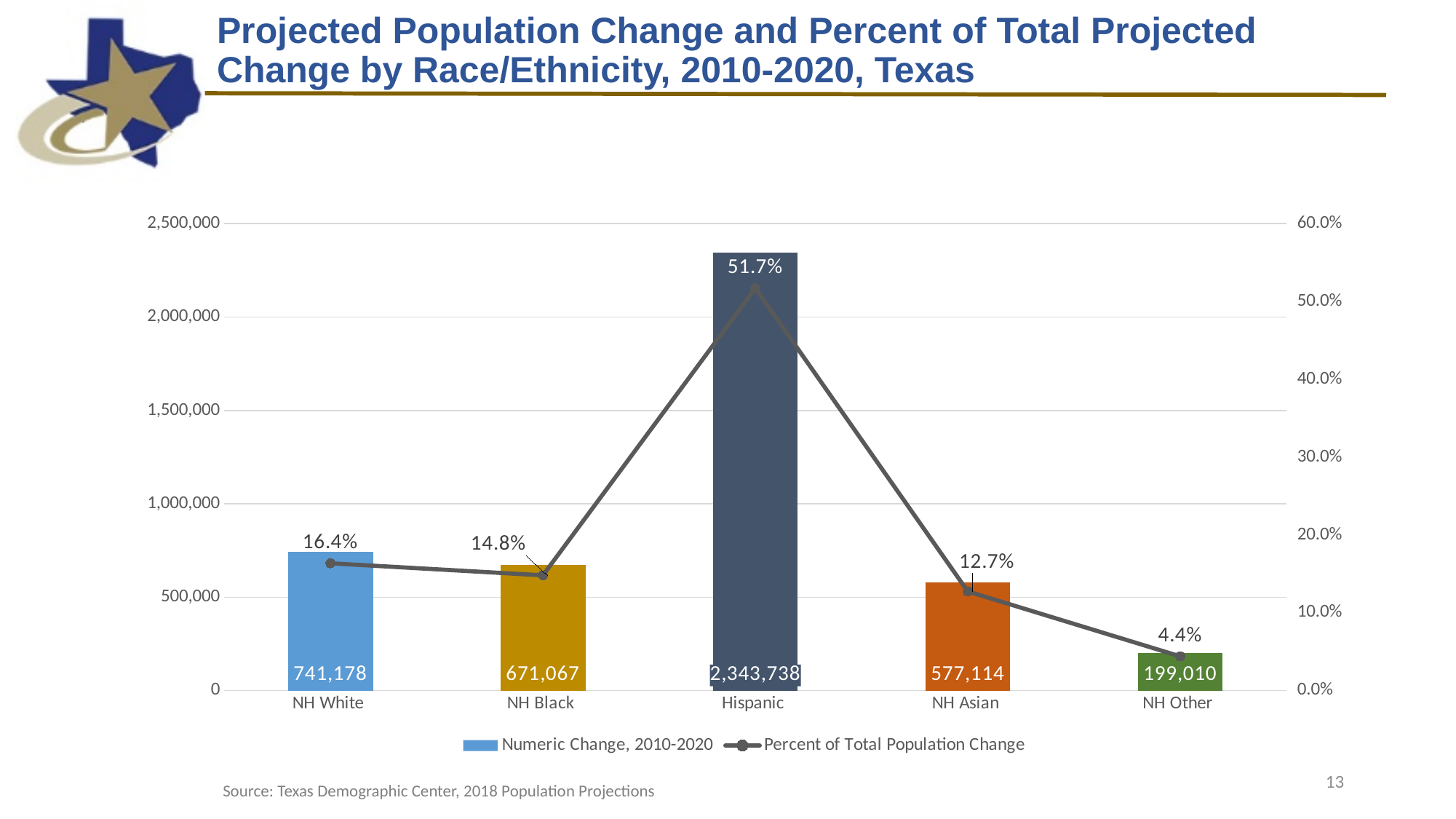
What is the Numeric Change, 2010-2020 for Hispanic? 2,343,738 Which race/ethnicity group has the lowest Percent of Total Population Change? NH Other How many race/ethnicity categories are shown on the x axis? 5 What is the Numeric Change, 2010-2020 for NH Asian? 577,114 Is the Numeric Change, 2010-2020 for Hispanic greater or less than 2,000,000? greater What is the difference in Numeric Change, 2010-2020 between NH White and NH Black? 70,111 What is the Percent of Total Population Change for NH Black? 14.8% Which race/ethnicity group has the highest Numeric Change, 2010-2020? Hispanic Which has a larger Numeric Change, 2010-2020: NH White or NH Asian? NH White What is the source cited below the chart? Texas Demographic Center, 2018 Population Projections What is the Percent of Total Population Change for NH Other? 4.4% How many series does the legend list? 2